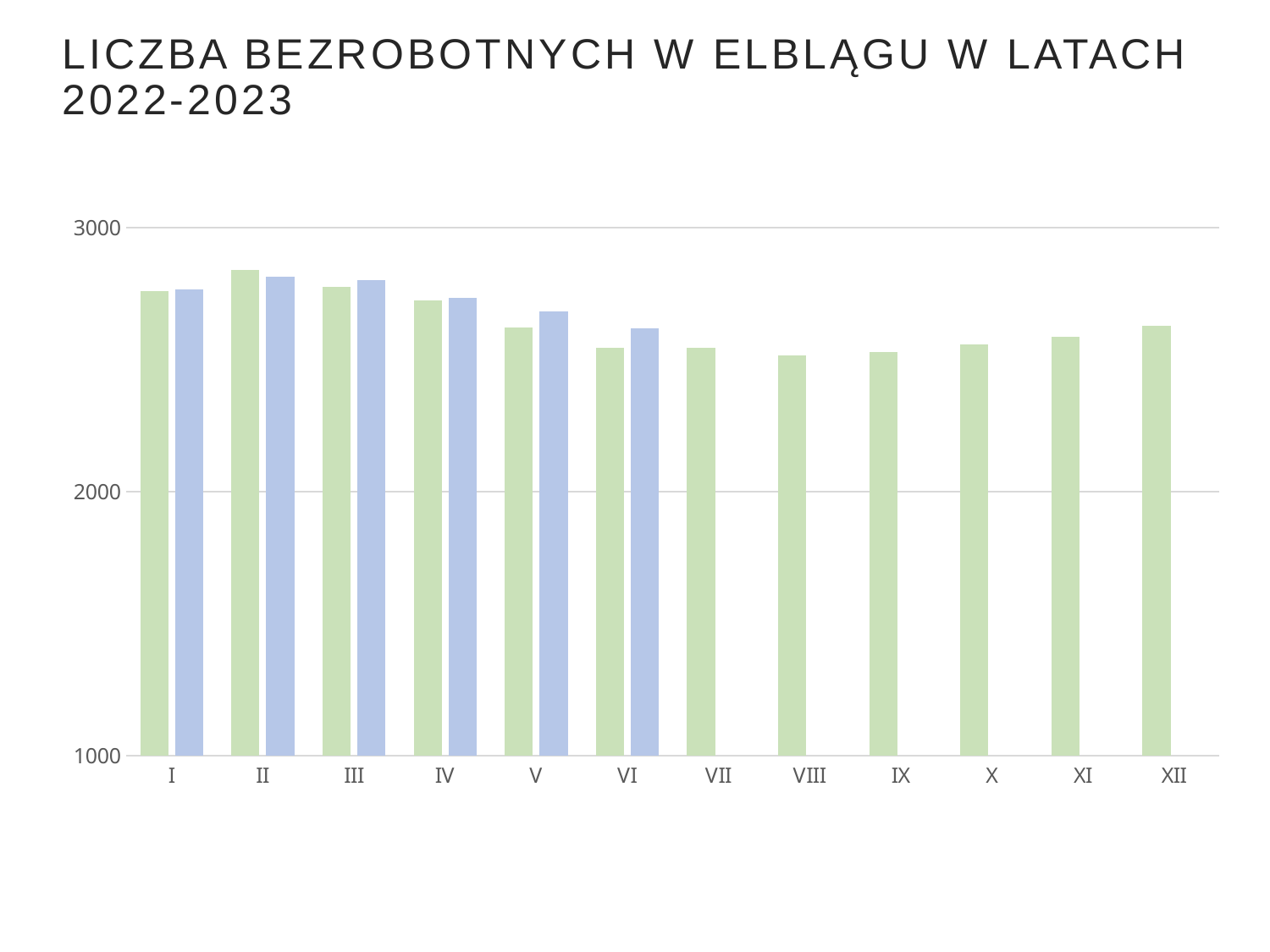
Which category has the highest green bar? II Which category has the highest blue bar? II Which category has the lowest blue bar? VI Is the value of the green bar for VIII greater or less than 3000? less Is the value of the green bar for II greater or less than 2000? greater What is the title of the chart? LICZBA BEZROBOTNYCH W ELBLĄGU W LATACH 2022-2023 Which is larger, the green bar for II or the green bar for VII? II Do the blue bars rise or fall from II to VI? fall What kind of chart is shown on the slide? bar chart How many categories are shown on the x axis? 12 How many colours of bars are plotted on the chart? 2 Is the value of the blue bar for VI greater or less than 2000? greater